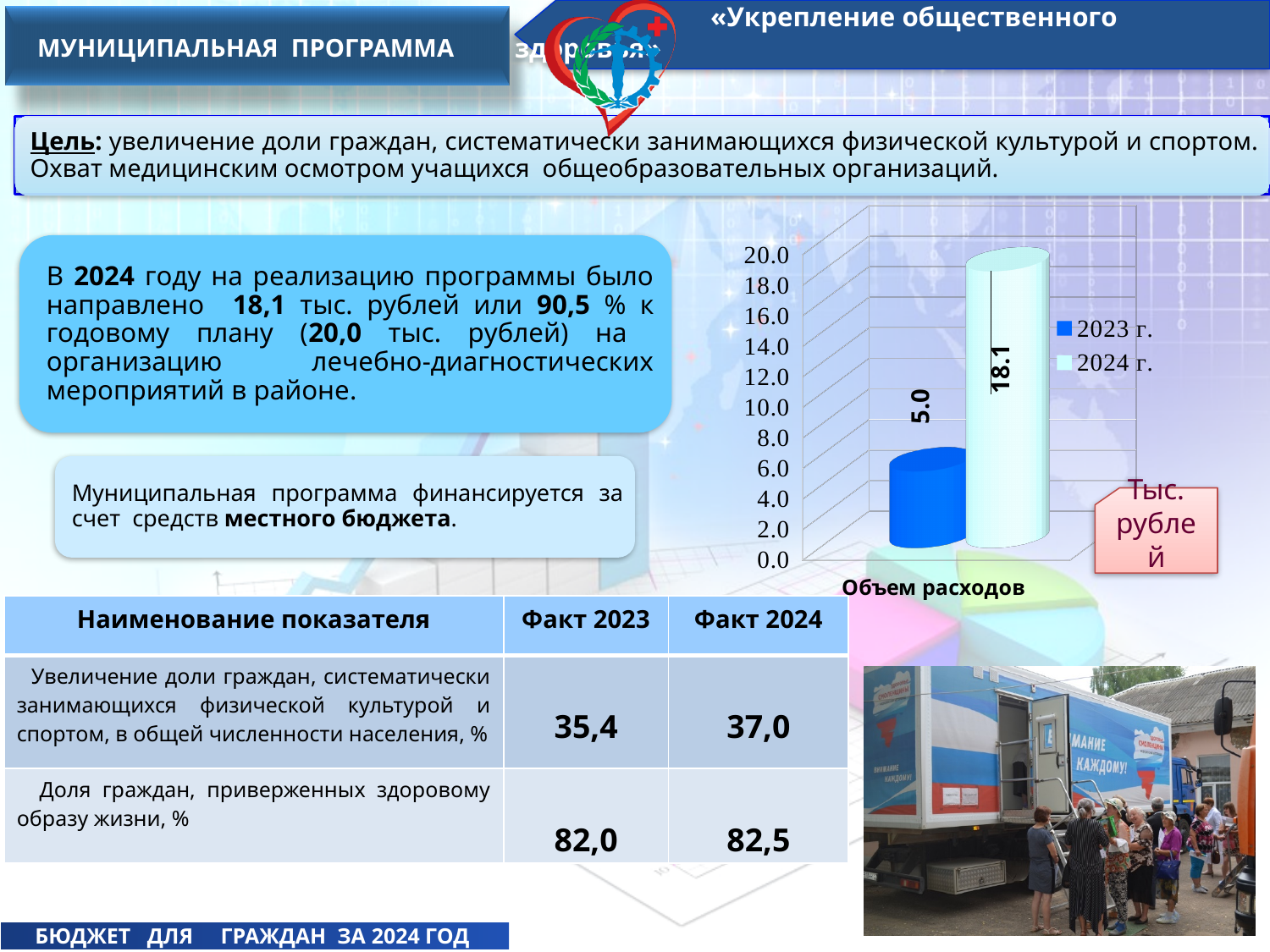
How many series does the chart legend list? 2 Which series has the lowest value in the chart? 2023 г. What is the category label shown below the chart? Объем расходов What is the difference between the 2024 г. value and the 2023 г. value in the chart? 13.1 What is the maximum value shown on the chart's vertical axis? 20.0 What kind of chart is shown on the slide? Bar chart Which series has the highest value in the chart? 2024 г. What is the value for 2023 г. in the chart? 5.0 What is the value for 2024 г. in the chart? 18.1 Which series has the higher value in the chart, 2023 г. or 2024 г.? 2024 г. Is the value for 2023 г. greater or less than 8.0? less Is the value for 2024 г. greater or less than 16.0? greater